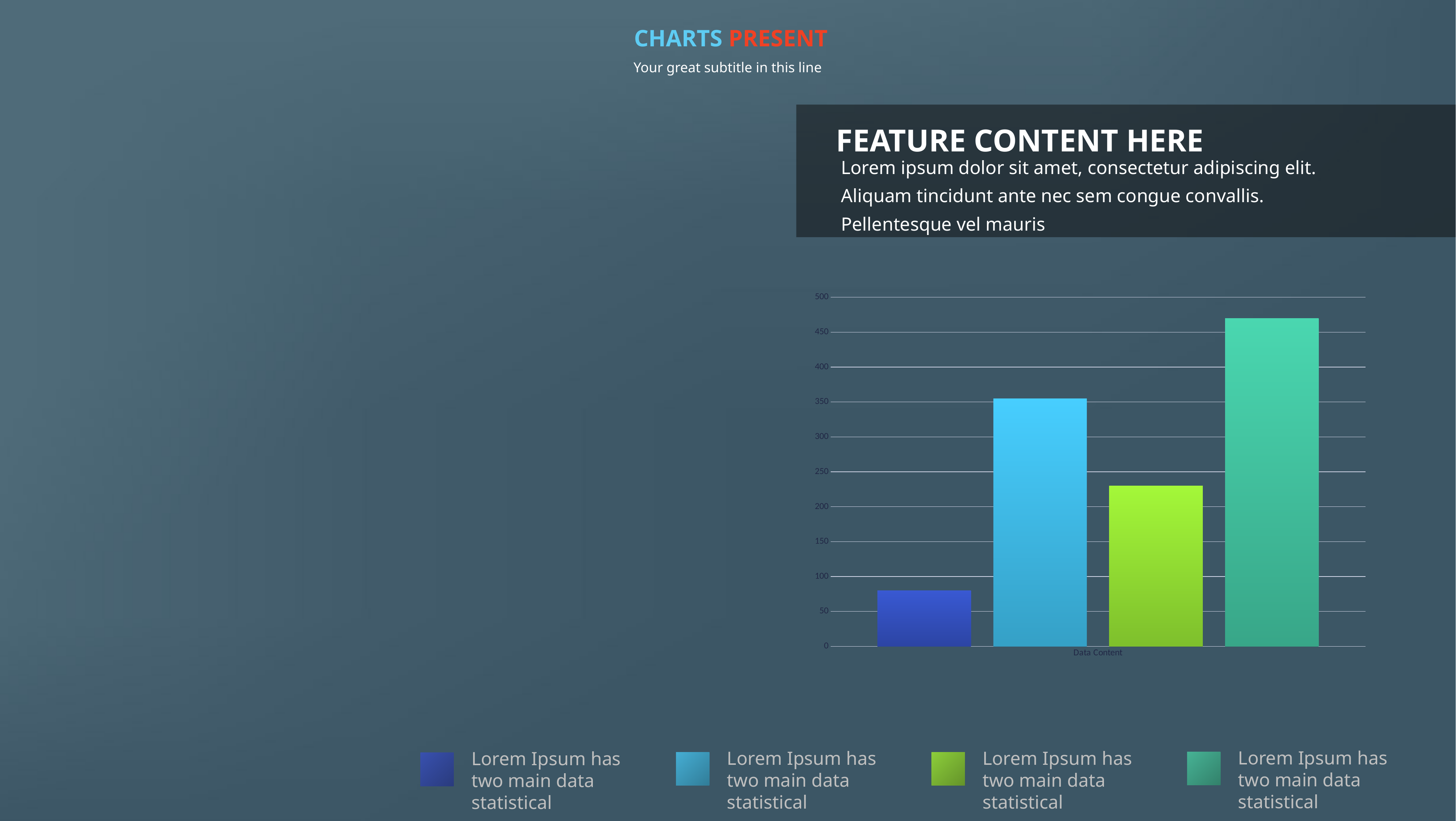
Is the value of the dark blue (first) bar greater or less than 100? less What is the category label shown on the x axis of the chart? Data Content Which bar is the tallest in the chart? the teal (fourth) bar Is the value of the green (third) bar greater or less than 250? less Is the value of the teal (fourth) bar greater or less than 450? greater What kind of chart is shown on the slide? bar chart How many bars are plotted in the chart? 4 What is the highest value shown on the chart's vertical axis? 500 Which bar is the shortest in the chart? the dark blue (first) bar Is the light blue (second) bar taller or shorter than the green (third) bar? taller